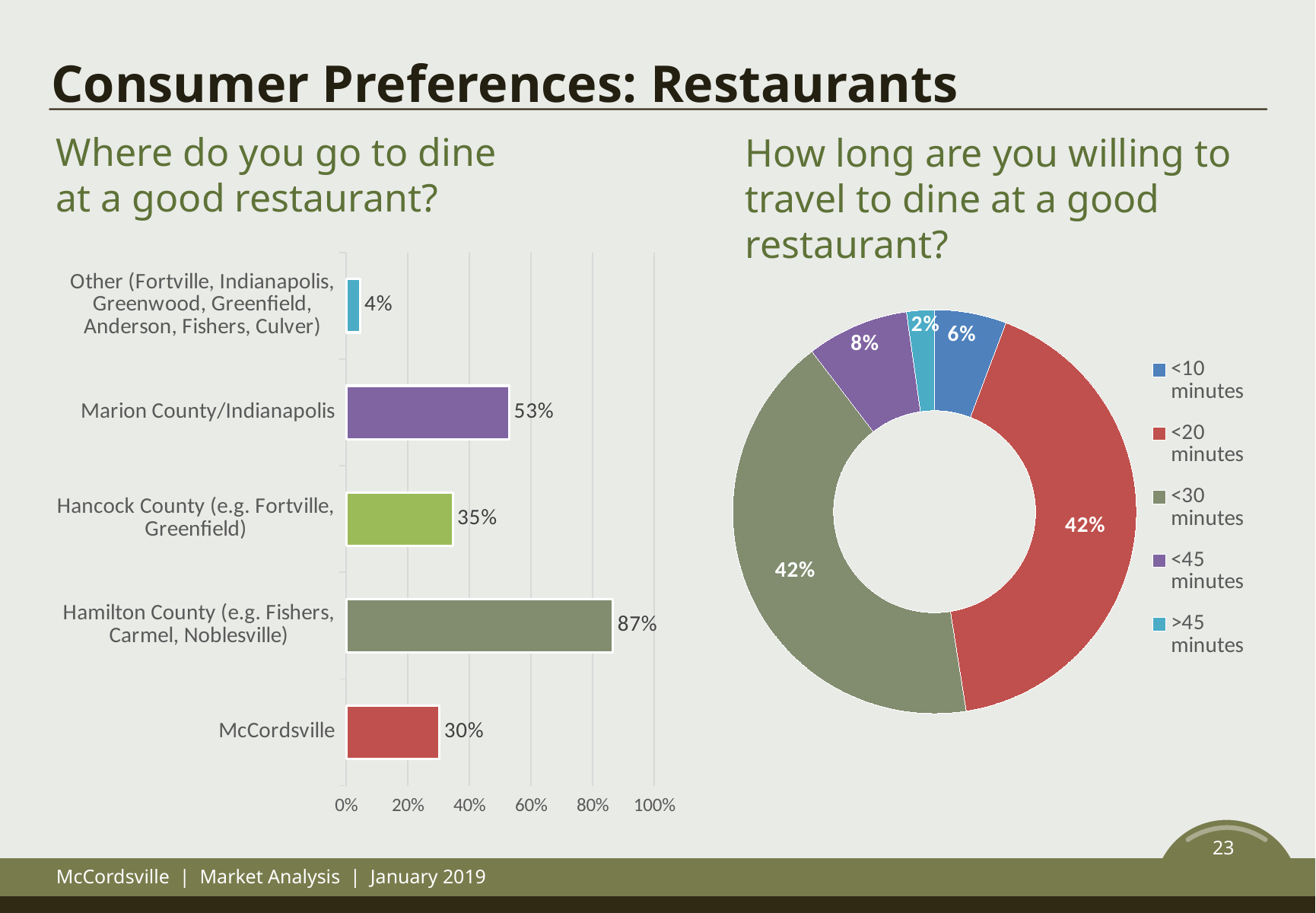
In the 'Where do you go to dine at a good restaurant?' chart, what is the value for McCordsville? 30% How many categories are shown in the 'Where do you go to dine at a good restaurant?' chart? 5 In the 'Where do you go to dine at a good restaurant?' chart, which category has the lowest value? Other (Fortville, Indianapolis, Greenwood, Greenfield, Anderson, Fishers, Culver) In the 'Where do you go to dine at a good restaurant?' chart, what is the value for Hamilton County (e.g. Fishers, Carmel, Noblesville)? 87% In the 'How long are you willing to travel to dine at a good restaurant?' chart, which category has the smallest share? >45 minutes In the 'Where do you go to dine at a good restaurant?' chart, which category has the highest value? Hamilton County (e.g. Fishers, Carmel, Noblesville) What kind of chart is the 'Where do you go to dine at a good restaurant?' chart? Bar chart How many entries does the legend of the 'How long are you willing to travel to dine at a good restaurant?' chart list? 5 In the 'How long are you willing to travel to dine at a good restaurant?' chart, what share is '<10 minutes'? 6% In the 'Where do you go to dine at a good restaurant?' chart, which is larger: the value for Hancock County (e.g. Fortville, Greenfield) or McCordsville? Hancock County (e.g. Fortville, Greenfield) In the 'How long are you willing to travel to dine at a good restaurant?' chart, what share is '<45 minutes'? 8% In the 'Where do you go to dine at a good restaurant?' chart, what is the difference between the values for Marion County/Indianapolis and Hancock County (e.g. Fortville, Greenfield)? 18%